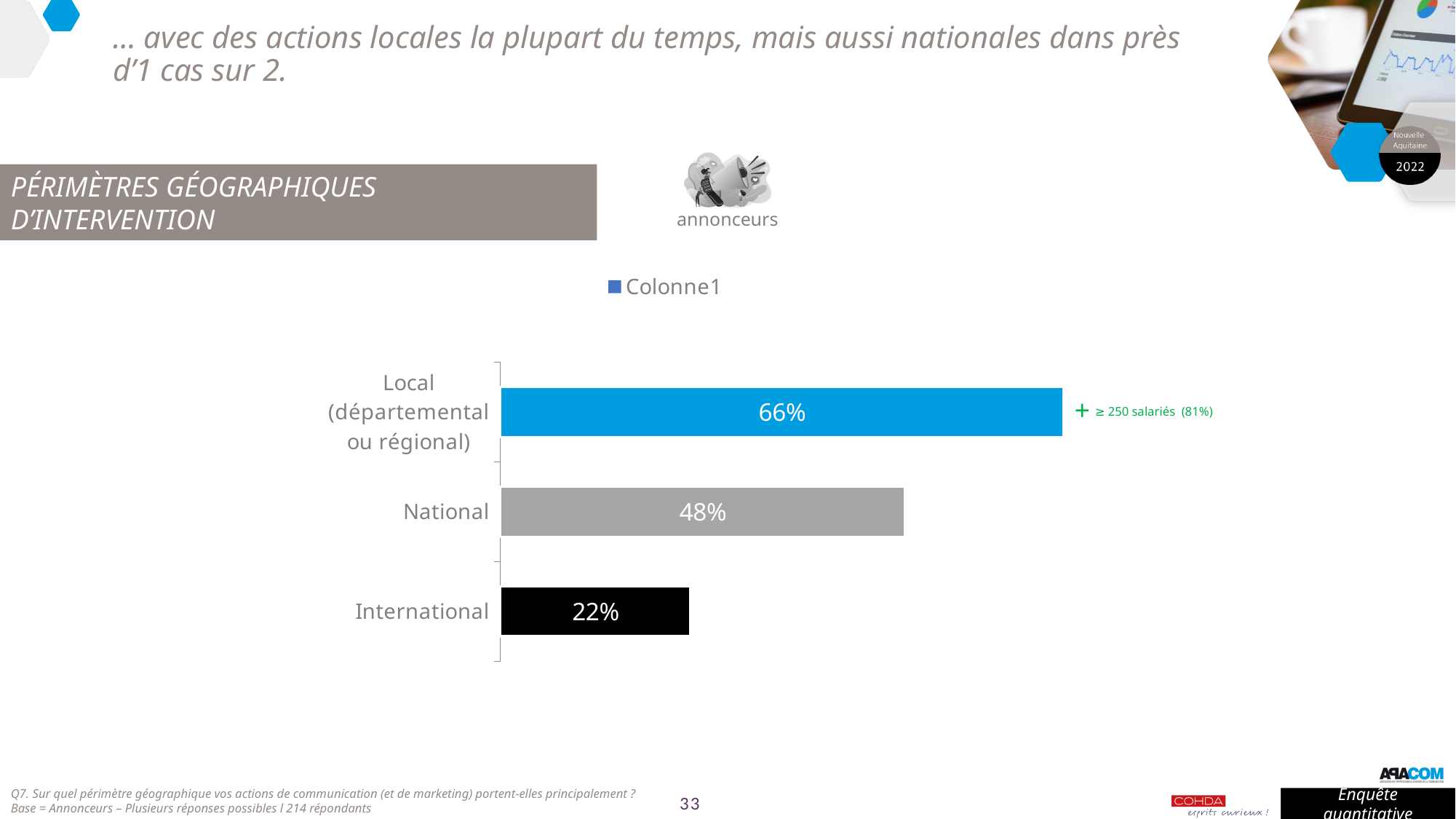
What is the value for National? 48% What is the value for Local (départemental ou régional)? 66% What kind of chart is shown on the slide? Bar chart Which category has the lowest value? International Which category has the highest value? Local (départemental ou régional) How many categories are shown in the chart? 3 How many series does the legend list? 1 Which is larger, the value for National or the value for International? National What is the name of the series listed in the legend? Colonne1 What is the difference between the values for Local (départemental ou régional) and National? 18% What is the difference between the values for National and International? 26% What is the value for International? 22%